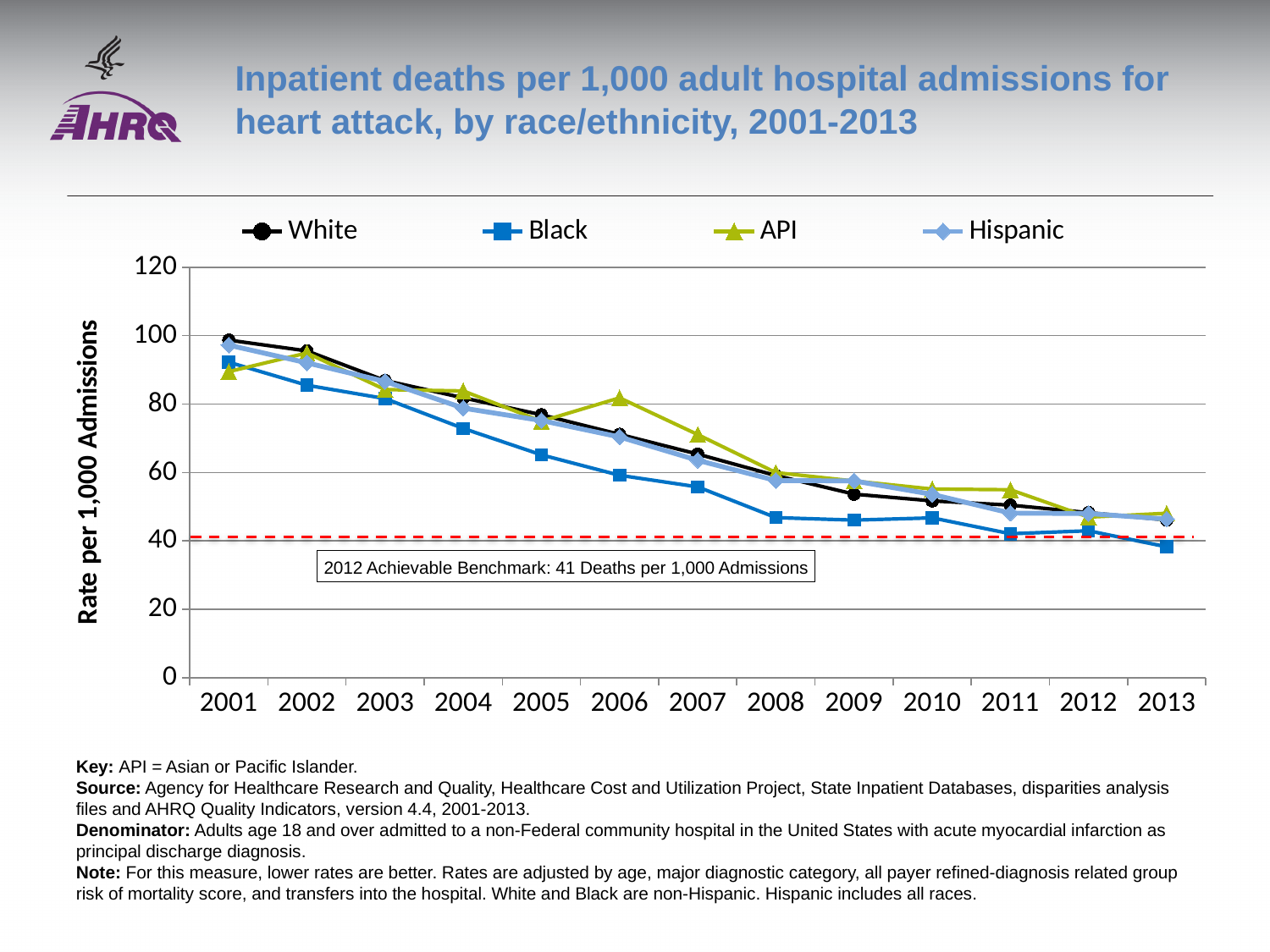
What is the title of the y axis? Rate per 1,000 Admissions Which series has the lowest value in 2013? Black How many years are plotted along the x axis? 13 What is the 2012 achievable benchmark shown on the chart? 41 Deaths per 1,000 Admissions Is the value for Black in 2005 greater or less than 60? greater Which series has the highest value in 2006? API In 2006, which is larger, the value for API or the value for Black? API What kind of chart is shown on the slide? Line chart How many series does the legend list? 4 Is the value for White in 2001 greater or less than 80? greater Does the White series rise or fall from 2001 to 2013? Fall Is the value for Black in 2013 greater or less than 40? less